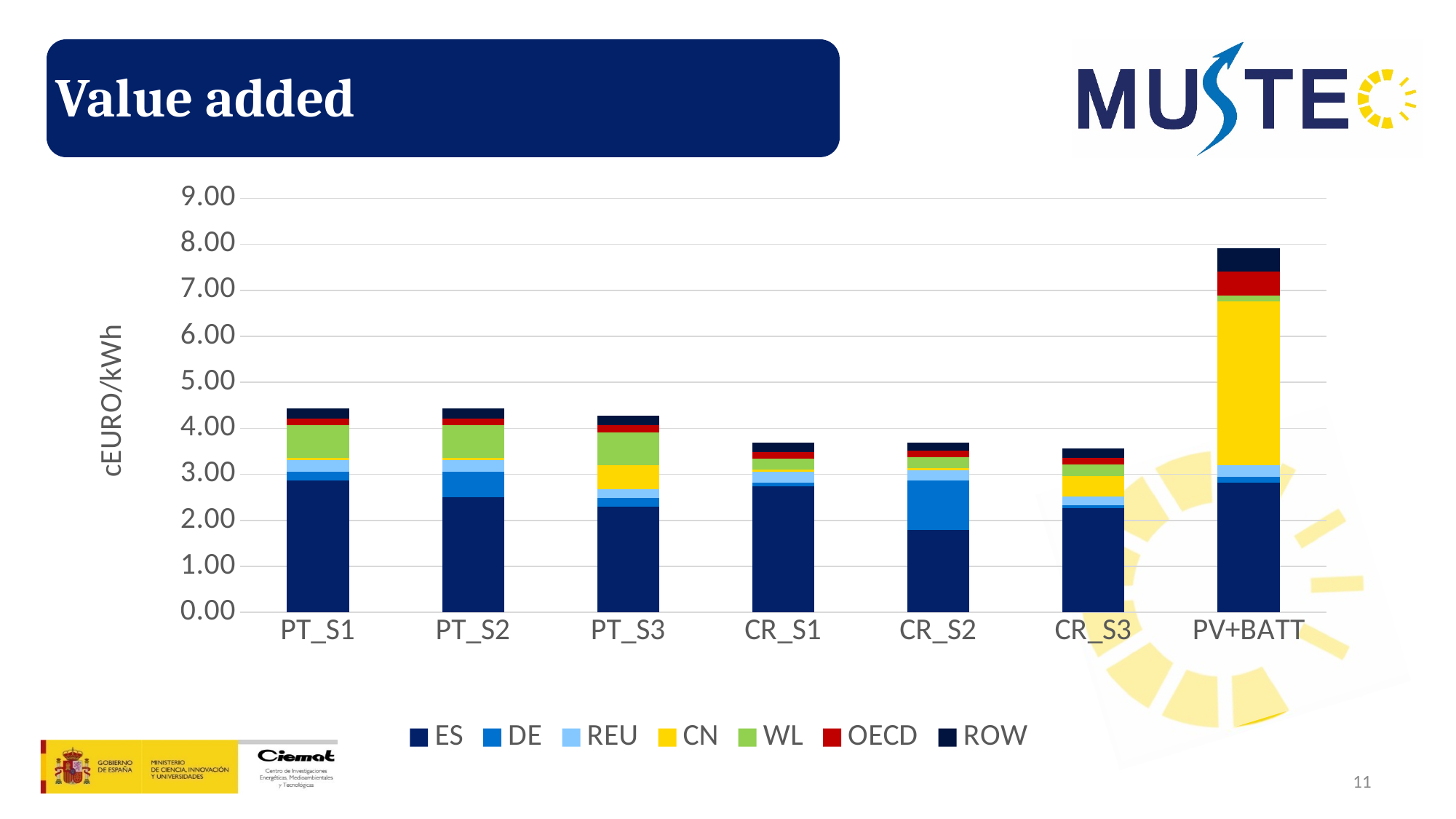
Which has a larger total value, PT_S1 or CR_S1? PT_S1 How many series does the legend list? 7 What kind of chart is shown on the slide? Stacked bar chart What is the label of the y axis? cEURO/kWh Is the total value for CR_S1 greater or less than 4.00? less How many categories are shown on the x axis of the chart? 7 Which category has the smallest ES segment? CR_S2 Which category has the highest total value added? PV+BATT Is the total value for PT_S1 greater or less than 4.00? greater Is the ES segment for CR_S2 greater or less than 2.00? less Which category has a larger DE segment, PT_S1 or CR_S2? CR_S2